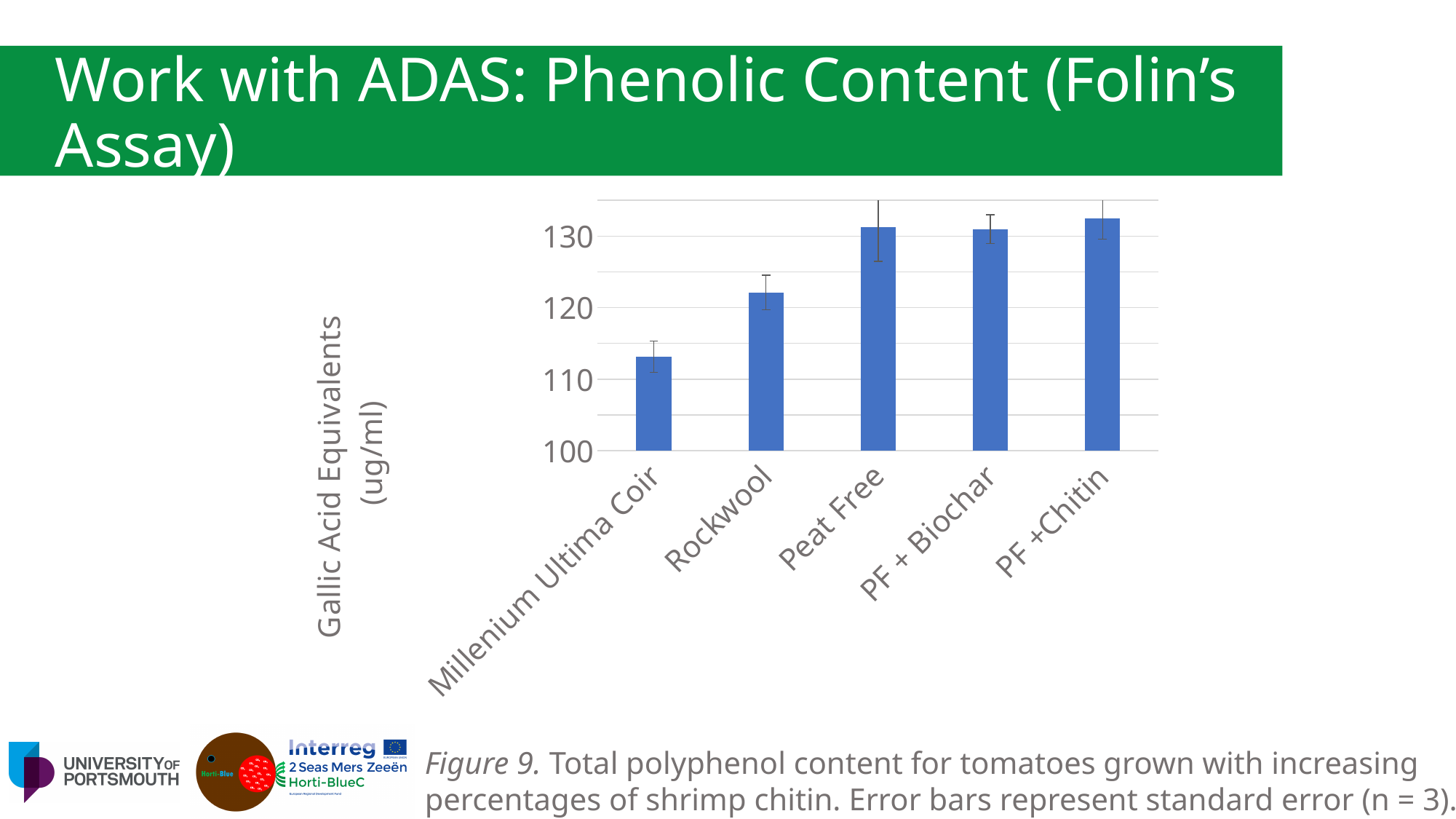
How many growing media categories are plotted on the x axis? 5 Is the value for PF +Chitin greater or less than 130? greater Is the value for Rockwool greater or less than 120? greater What kind of chart is shown on the slide? bar chart Which has the larger value, Peat Free or Rockwool? Peat Free Do the values generally rise or fall moving from left to right along the x axis? rise Which category has the lowest Gallic Acid Equivalents value? Millenium Ultima Coir Which has the larger value, Rockwool or Millenium Ultima Coir? Rockwool Is the value for Millenium Ultima Coir greater or less than 110? greater What is the label on the y axis of the chart? Gallic Acid Equivalents (ug/ml)